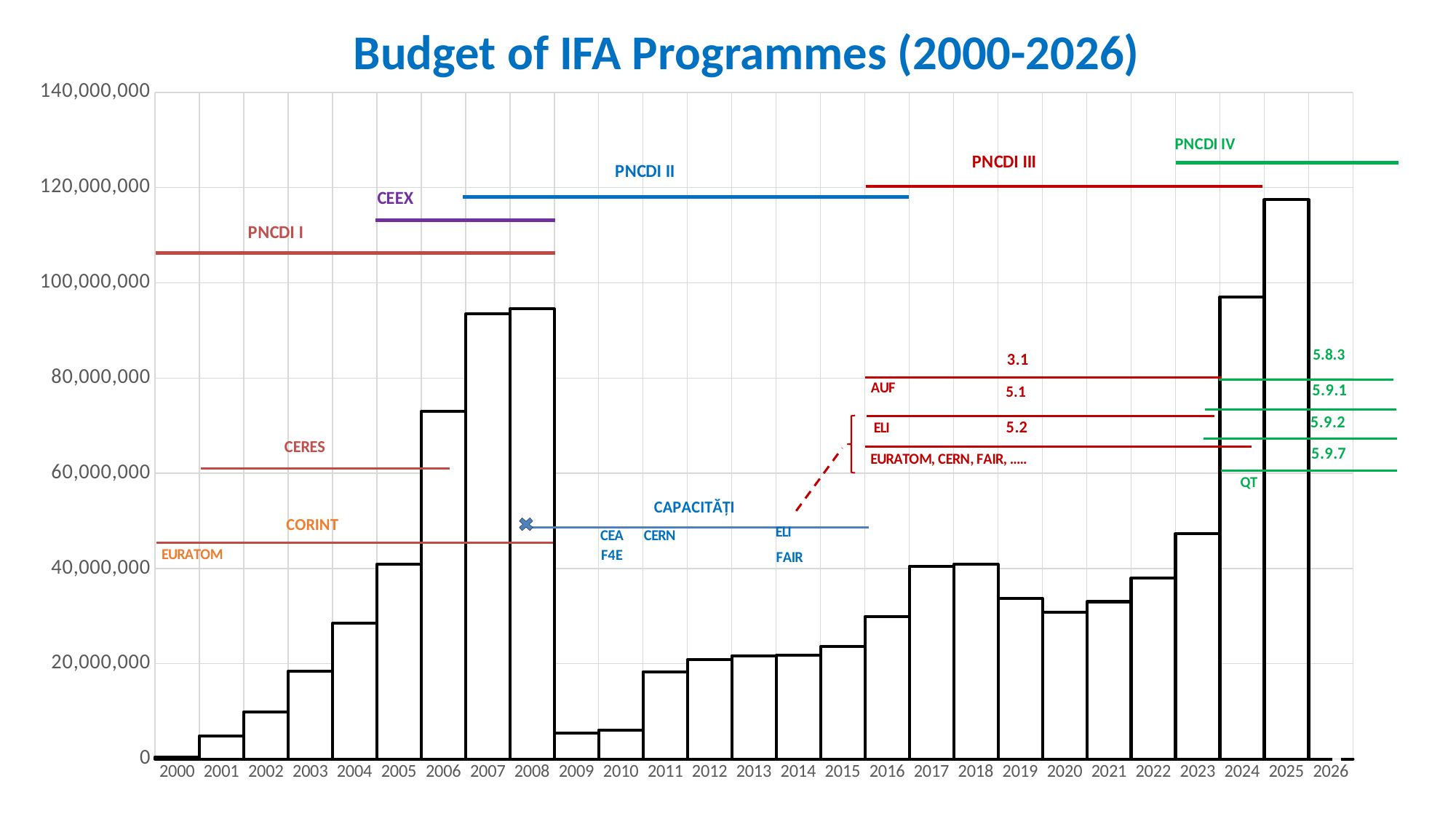
Is the value for 2025 greater or less than 100,000,000? greater Is the value for 2009 greater or less than 20,000,000? less Is the value for 2024 greater or less than 100,000,000? less Which year has the highest budget bar? 2025 How many years are shown on the x axis? 27 What kind of chart is shown on the slide? bar chart What is the title of the chart? Budget of IFA Programmes (2000-2026) Do the budget values rise or fall from 2009 to 2016? rise What colour is the line marking the PNCDI IV period? green Which year has the larger budget, 2023 or 2024? 2024